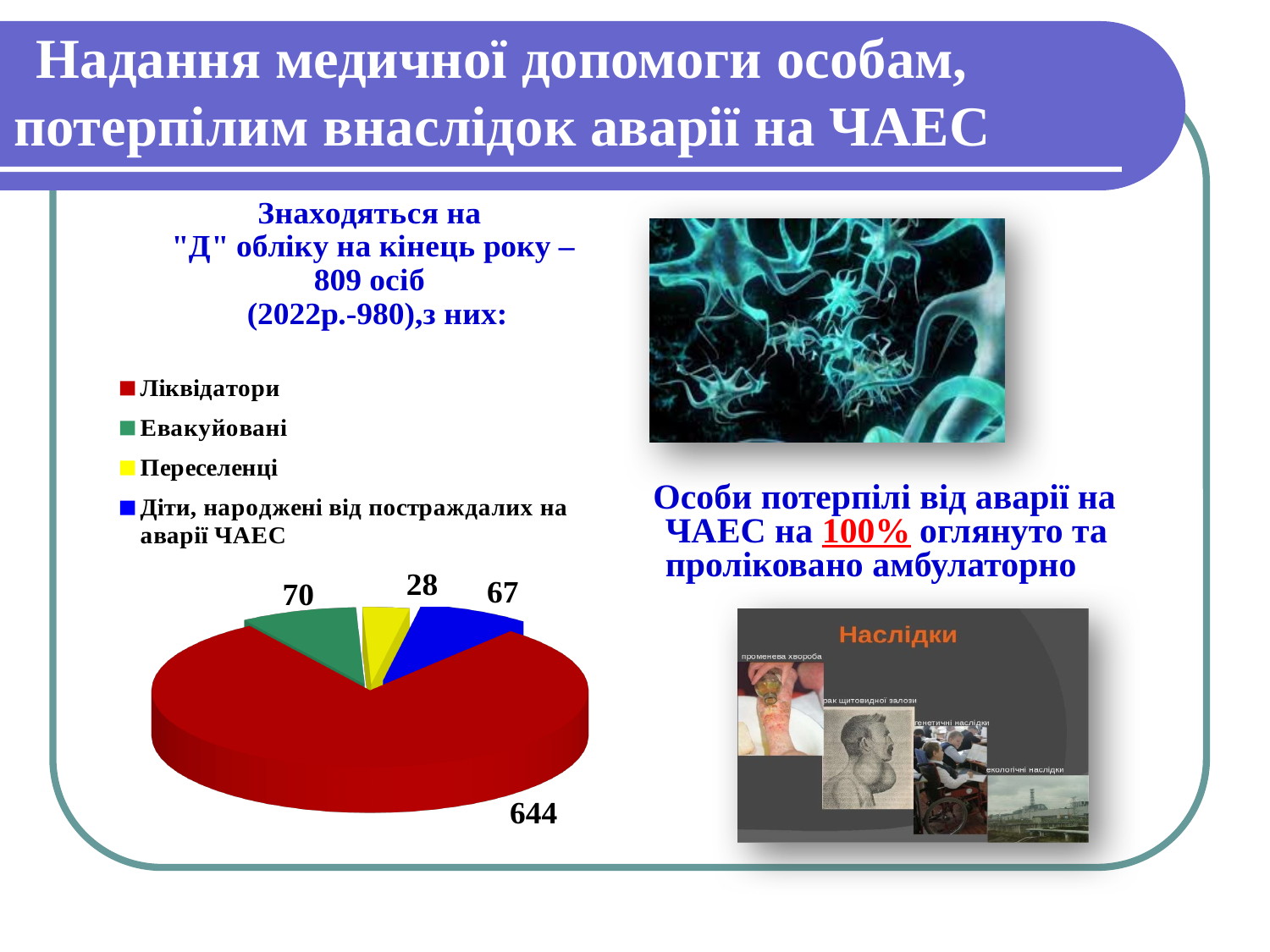
What colour is the slice for Переселенці in the pie chart? yellow How many categories does the pie chart legend list? 4 Which category has the largest slice in the pie chart? Ліквідатори What is the value for Ліквідатори in the pie chart? 644 What is the value for Евакуйовані in the pie chart? 70 What is the value for Переселенці in the pie chart? 28 What is the value for Діти, народжені від постраждалих на аварії ЧАЕС in the pie chart? 67 What is the difference between the values for Евакуйовані and Переселенці? 42 Which category has the smallest slice in the pie chart? Переселенці What type of chart is shown on the slide? pie chart What is the difference between the values for Ліквідатори and Евакуйовані? 574 Which is larger: the value for Евакуйовані or the value for Діти, народжені від постраждалих на аварії ЧАЕС? Евакуйовані